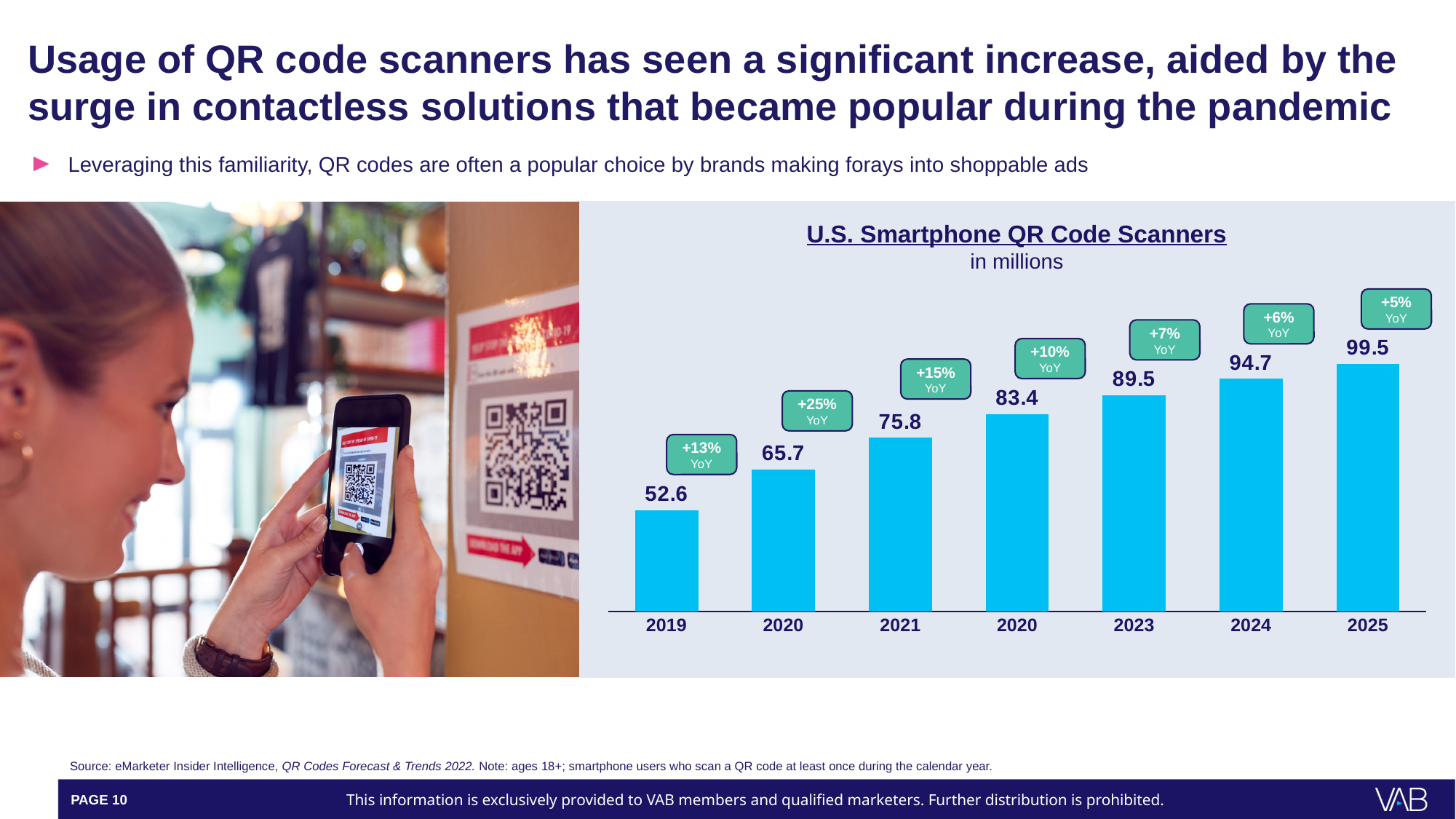
Which is larger in the U.S. Smartphone QR Code Scanners chart, the value for 2021 or the value for 2024? 2024 Which year has the highest value in the U.S. Smartphone QR Code Scanners chart? 2025 What is the value for 2019 in the U.S. Smartphone QR Code Scanners chart? 52.6 What is the value for 2023 in the U.S. Smartphone QR Code Scanners chart? 89.5 Do the values in the U.S. Smartphone QR Code Scanners chart rise or fall from left to right? Rise What YoY percentage is shown above the 2021 bar in the U.S. Smartphone QR Code Scanners chart? +15% What is the difference between the 2024 and 2023 values in the U.S. Smartphone QR Code Scanners chart? 5.2 What is the difference between the 2025 and 2019 values in the U.S. Smartphone QR Code Scanners chart? 46.9 What is the value for 2025 in the U.S. Smartphone QR Code Scanners chart? 99.5 What kind of chart is the U.S. Smartphone QR Code Scanners chart? Bar chart Which year has the lowest value in the U.S. Smartphone QR Code Scanners chart? 2019 How many bars are shown in the U.S. Smartphone QR Code Scanners chart? 7